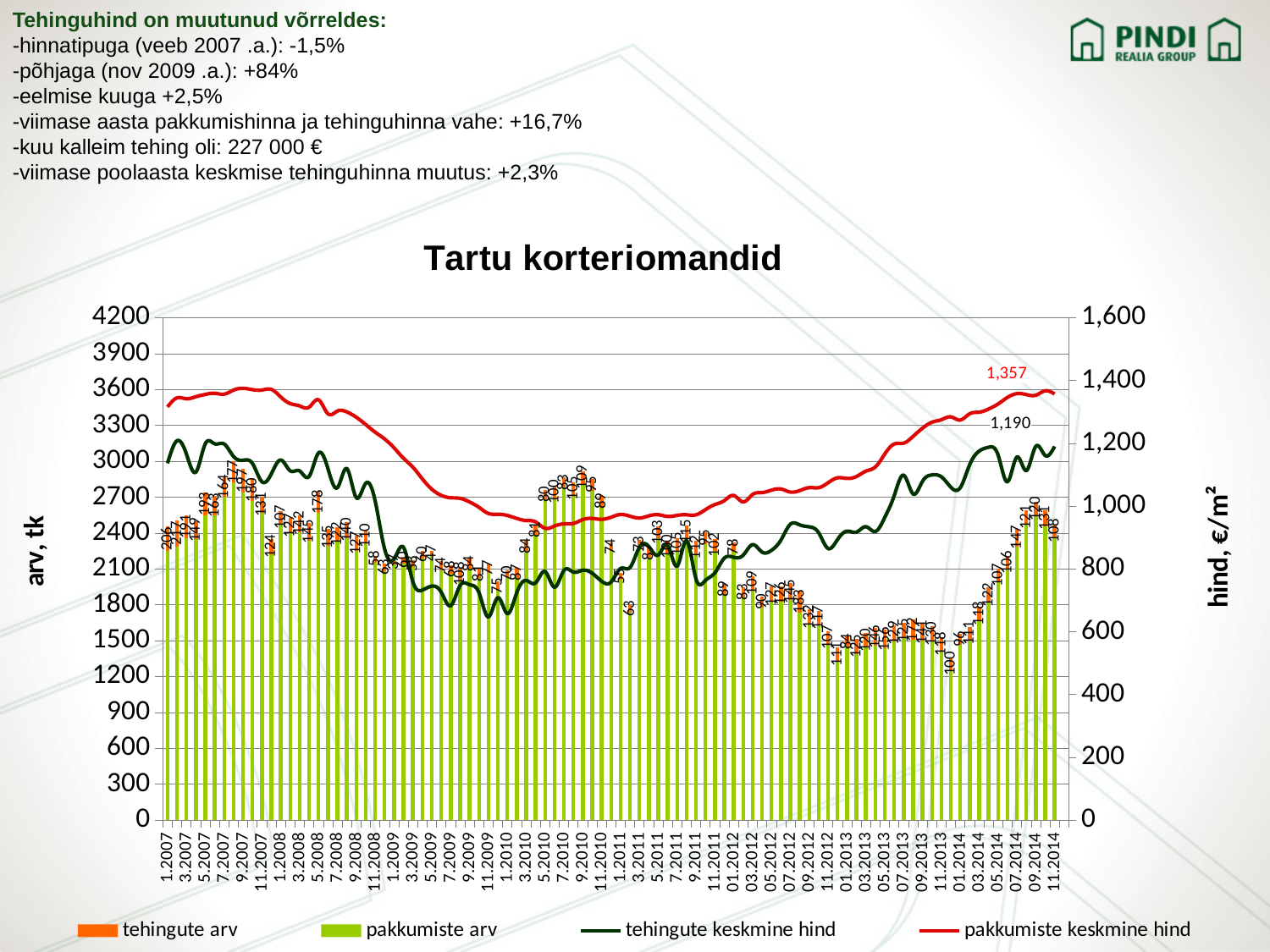
What is the difference between the labelled end values of pakkumiste keskmine hind (1,357) and tehingute keskmine hind (1,190)? 167 Is the value of pakkumiste keskmine hind at 11.2014 greater or less than 1,200? greater What kind of chart is shown on the slide? Combined bar and line chart How many series does the chart legend list? 4 Which colour is used for the pakkumiste keskmine hind line? Red Does pakkumiste keskmine hind rise or fall between 01.2013 and 11.2014? rise What is the title of the chart? Tartu korteriomandid What is the labelled value of pakkumiste keskmine hind at the end of the series (11.2014)? 1,357 At 11.2014, which is higher: pakkumiste keskmine hind or tehingute keskmine hind? pakkumiste keskmine hind Is the pakkumiste arv bar at 7.2007 greater or less than 2400? greater What is the labelled value of tehingute keskmine hind at the end of the series (11.2014)? 1,190